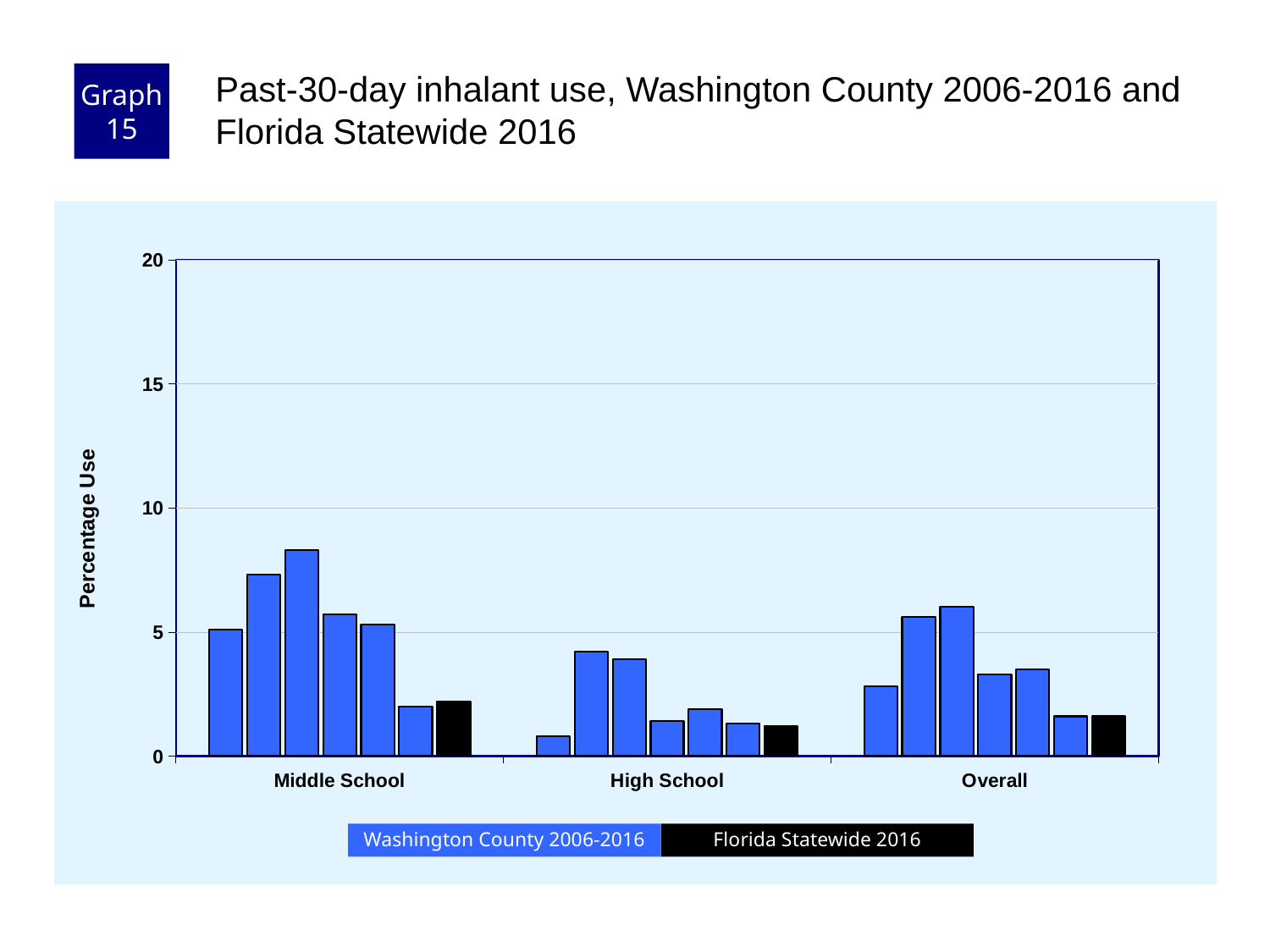
Which colour represents Florida Statewide 2016 in the legend? black Which category group contains the tallest bar on the chart? Middle School Is the Florida Statewide 2016 value for Middle School greater or less than 5? less What is the label of the y axis? Percentage Use Which category group contains the shortest bar on the chart? High School How many categories are shown on the x axis? 3 Is the tallest Washington County bar in the Middle School group greater or less than 5? greater How many series does the legend list? 2 Is the tallest Washington County bar in the Overall group greater or less than 10? less What kind of chart is shown on the slide? bar chart Is the Florida Statewide 2016 value larger for Middle School or for High School? Middle School